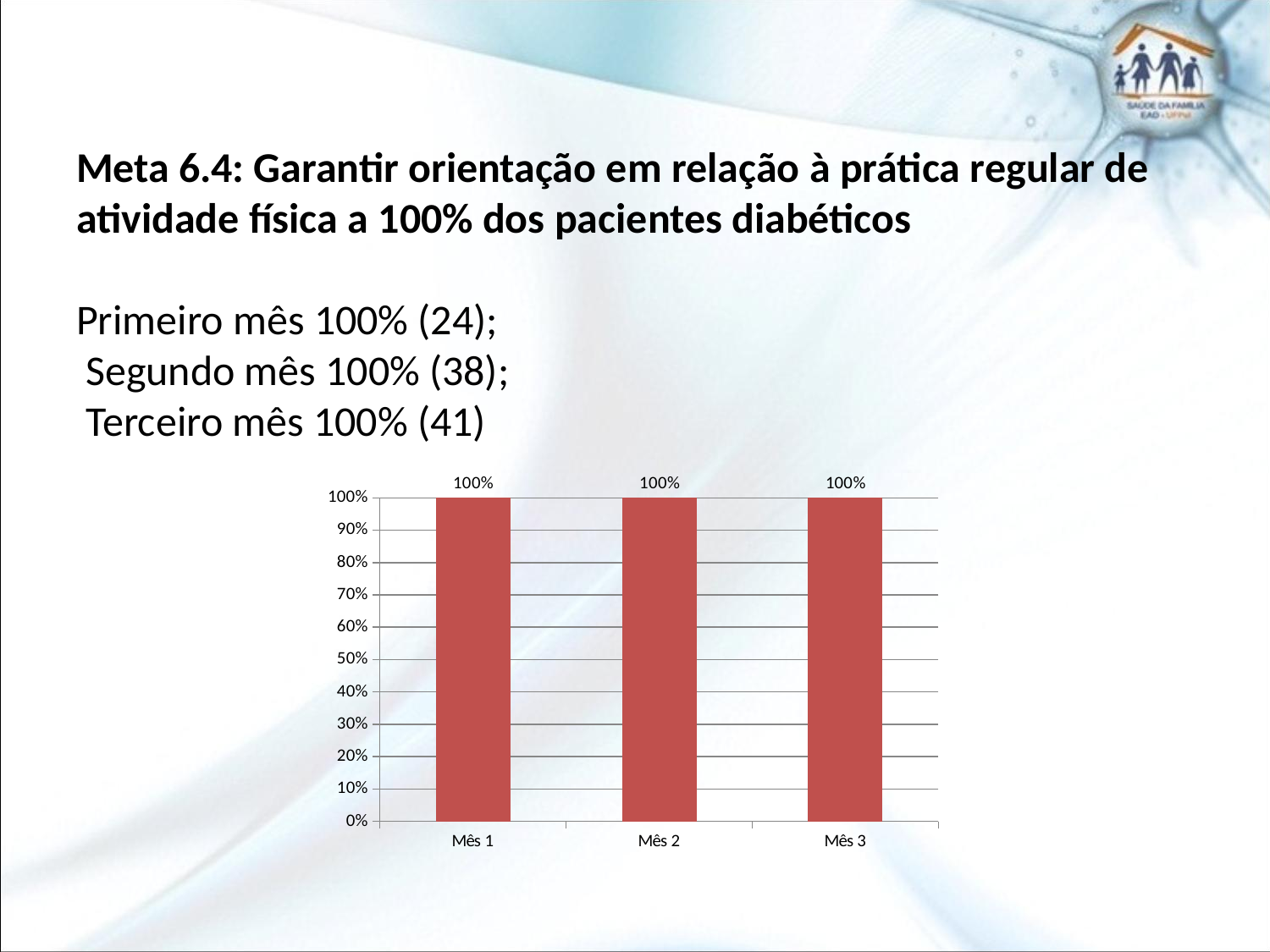
What kind of chart is shown on the slide? bar chart What is the value for Mês 2? 100% What is the value for Mês 1? 100% What is the highest value shown on the y axis of the chart? 100% What colour are the bars in the chart? red How many categories are shown on the x axis of the chart? 3 What is the value for Mês 3? 100% Do the values rise, fall or stay the same from Mês 1 to Mês 3? stay the same What is the difference between the values for Mês 3 and Mês 1? 0% Is the value for Mês 2 greater or less than 50%? greater